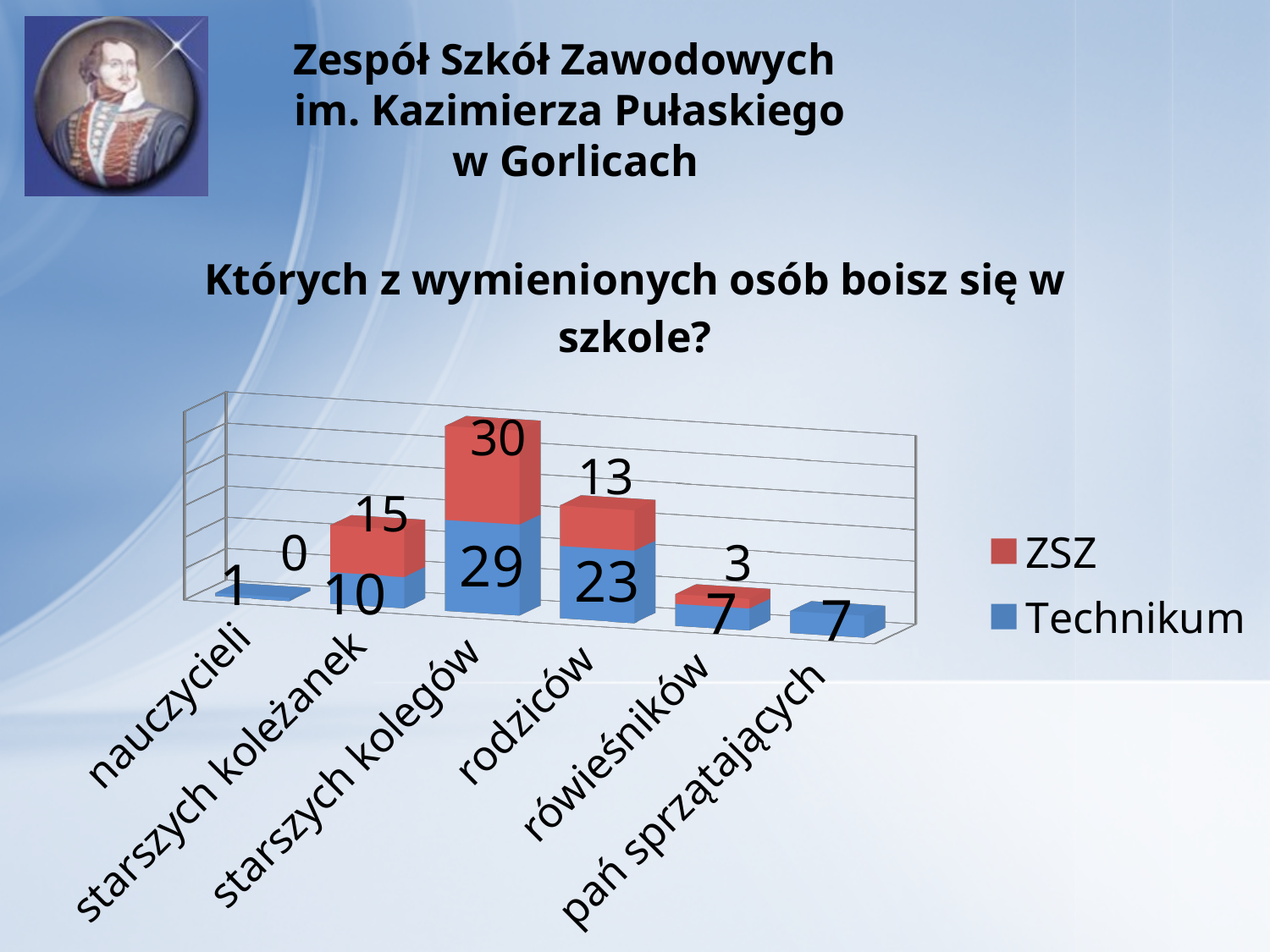
What is the ZSZ value for rodziców? 13 How many series does the legend list? 2 What is the difference between the Technikum and ZSZ values for rodziców? 10 Which category has the highest ZSZ value? starszych kolegów What kind of chart is shown on the slide? stacked bar chart What is the Technikum value for rówieśników? 7 How many categories are shown on the x axis? 6 What is the Technikum value for starszych kolegów? 29 What is the total of the stacked bar for starszych kolegów? 59 Which is larger for starszych koleżanek, the ZSZ value or the Technikum value? ZSZ Which category has the lowest Technikum value? nauczycieli What is the ZSZ value for starszych koleżanek? 15